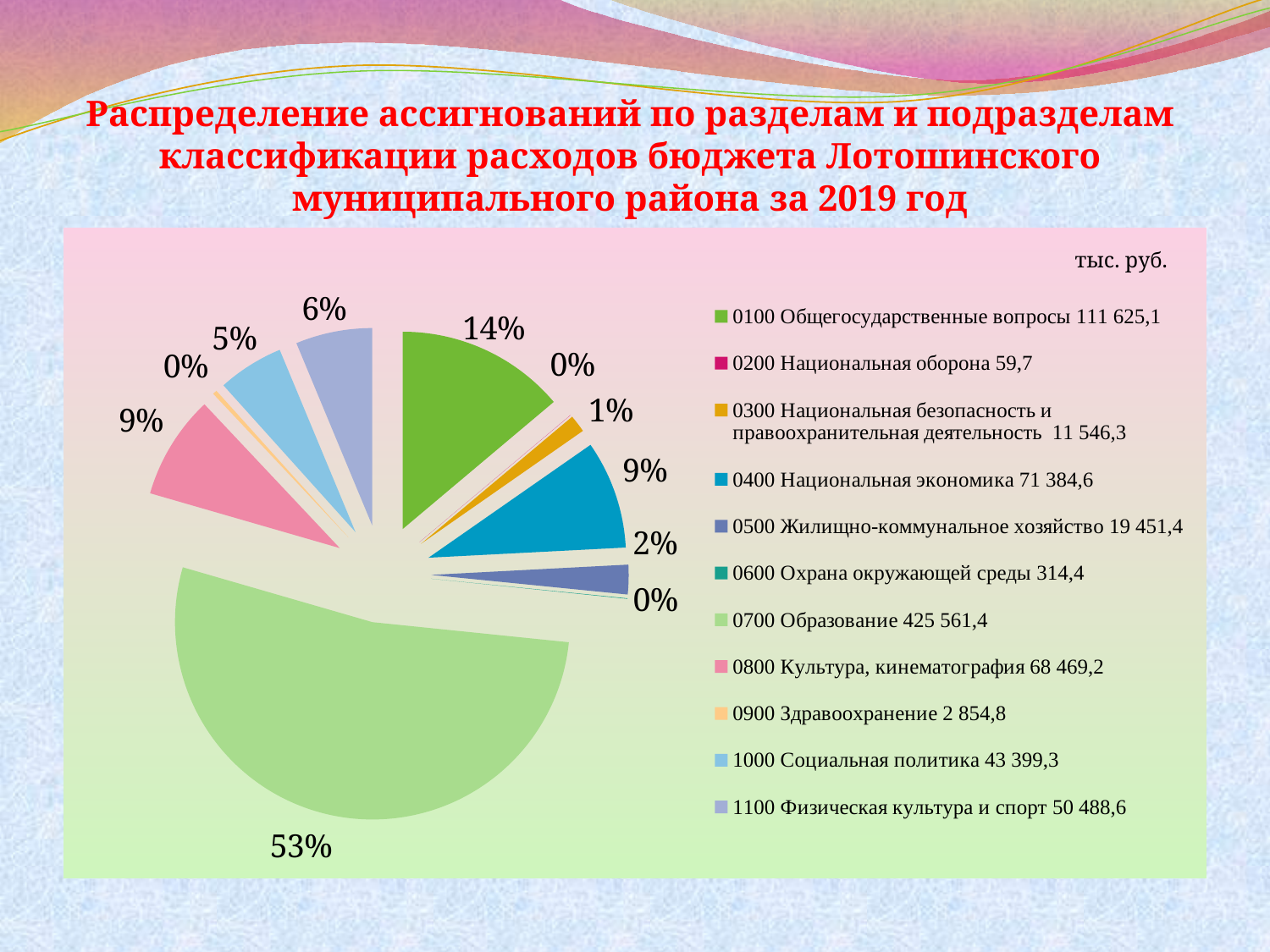
What is the value for 0400 Национальная экономика? 71 384,6 What percentage share of the pie does 0100 Общегосударственные вопросы have? 14% In what units are the values in the legend given? тыс. руб. Which is larger: 0800 Культура, кинематография or 1100 Физическая культура и спорт? 0800 Культура, кинематография What percentage share of the pie does 0700 Образование have? 53% What is the difference between the values for 0100 Общегосударственные вопросы and 0400 Национальная экономика? 40 240,5 What is the value for 0700 Образование? 425 561,4 What is the value for 1000 Социальная политика? 43 399,3 Which category has the smallest value? 0200 Национальная оборона What kind of chart is shown on the slide? pie chart Which category has the largest share of the pie? 0700 Образование How many categories does the legend of the pie chart list? 11